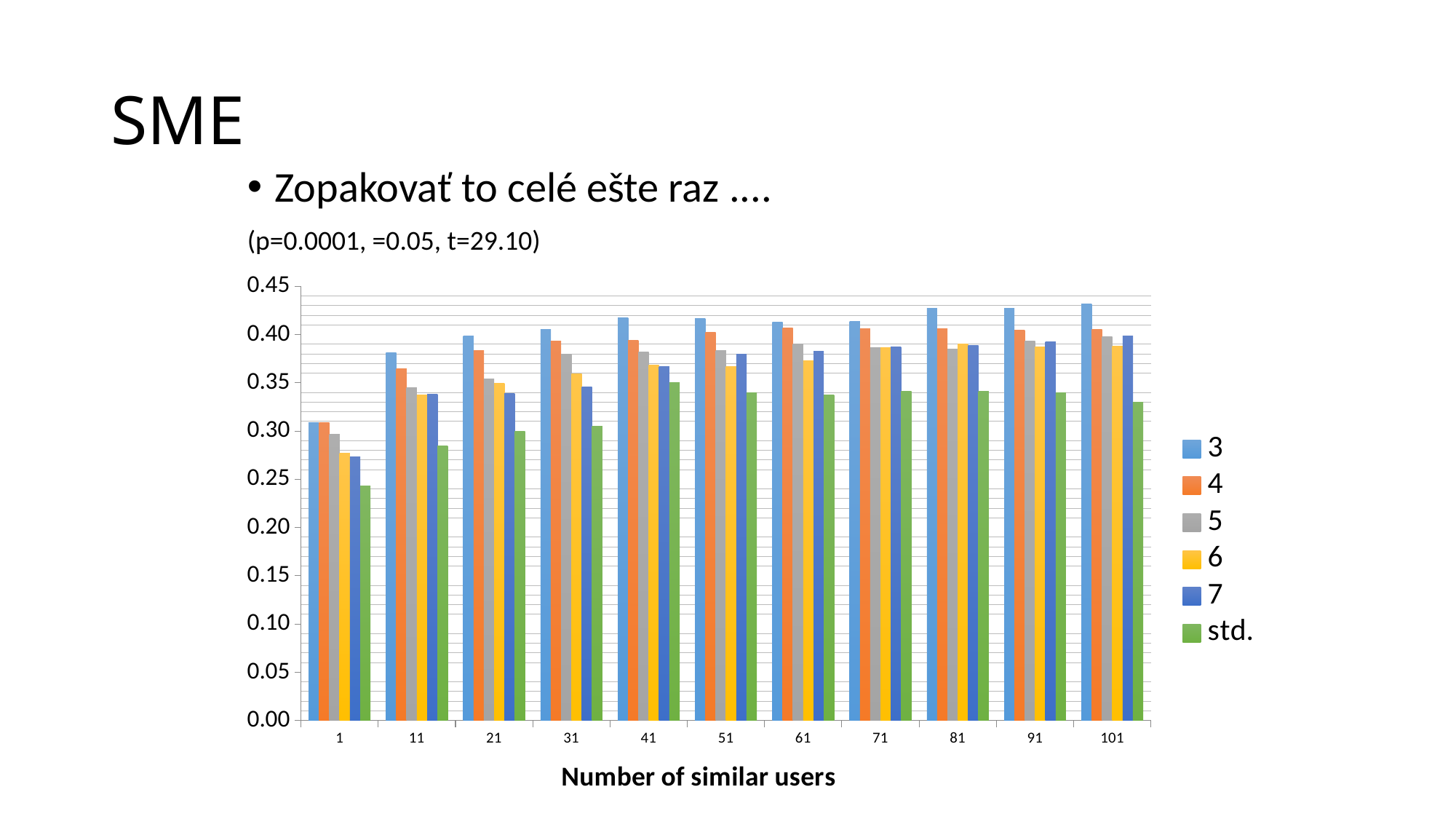
Is the value for series std. at 101 greater or less than 0.35? less At category 51, which is larger: series 3 or series std.? 3 What is the last entry in the legend? std. Is the value for series std. at 1 greater or less than 0.25? less Is the value for series 3 at 101 greater or less than 0.40? greater What is the title of the x axis? Number of similar users Which series has the lowest value at category 1? std. Which series has the highest value at category 101? 3 How many categories are shown on the x axis? 11 How many series does the legend list? 6 What kind of chart is shown on the slide? bar chart